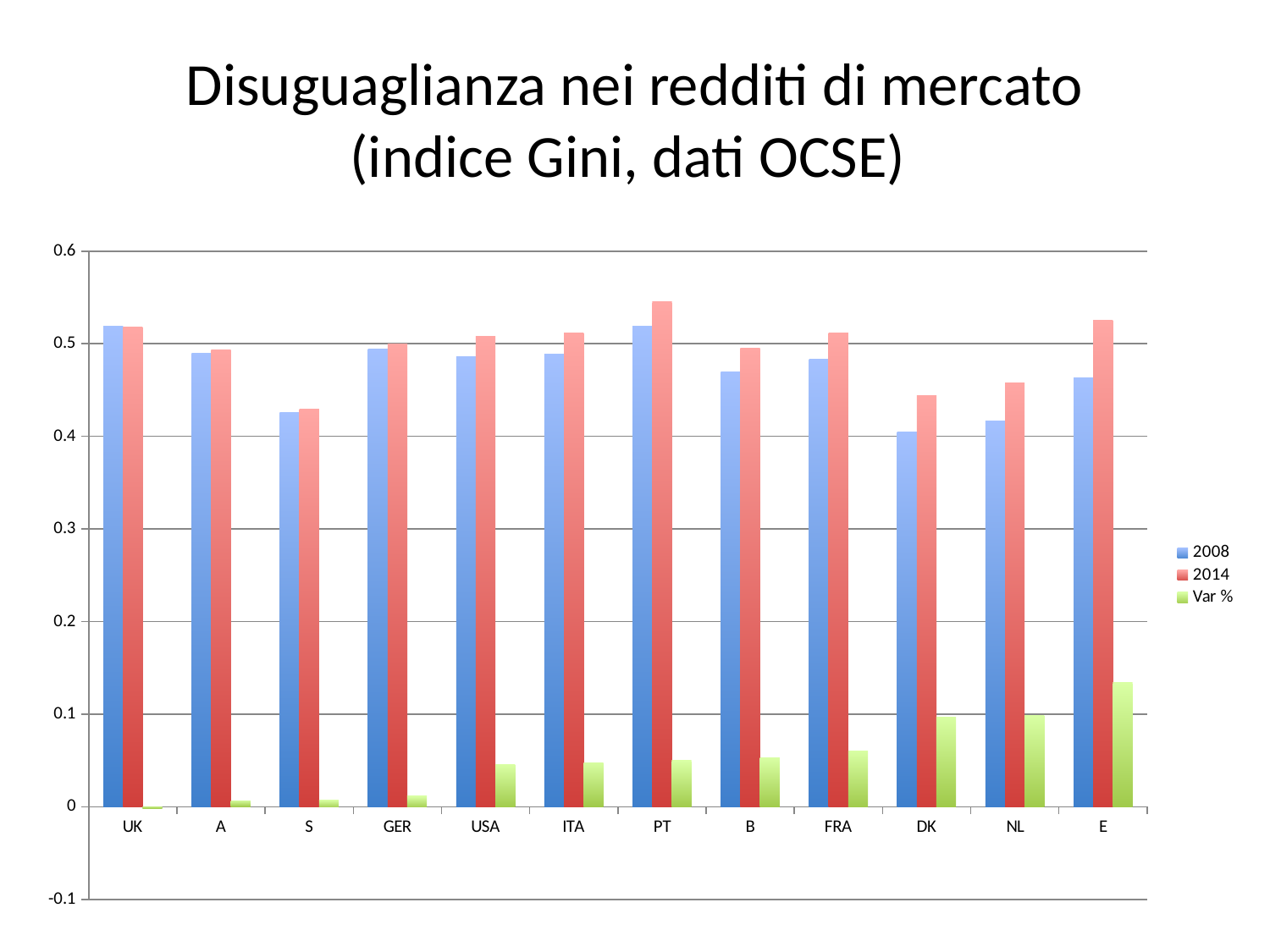
For E, which is larger: the 2008 value or the 2014 value? 2014 How many series does the legend list? 3 How many countries are shown on the x axis? 12 Which series is shown in green in the legend? Var % Is the 2008 value for S greater or less than 0.5? less Which country has the highest Var % value? E Which country has the highest 2014 value? PT Is the 2014 value for PT greater or less than 0.5? greater What kind of chart is shown on the slide? bar chart Is the Var % value for E greater or less than 0.1? greater Which country has the lowest 2014 value? S Which country has the lowest Var % value? UK